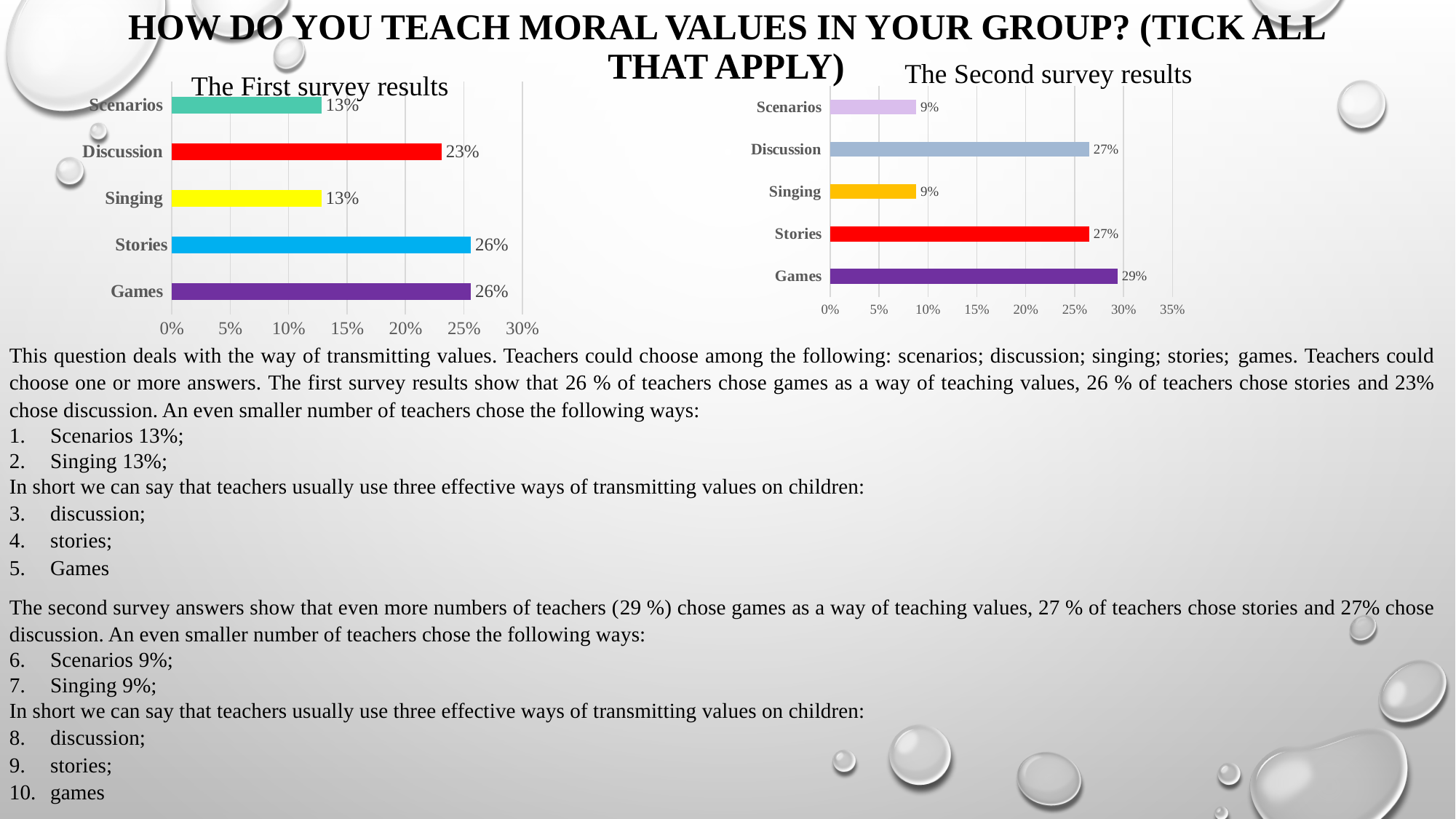
What kind of chart is "The Second survey results"? Bar chart In the chart titled "The Second survey results", which category has the highest value? Games In the chart titled "The Second survey results", what is the difference between the values for Discussion and Singing? 18% In the chart titled "The Second survey results", what is the value for Games? 29% In the chart titled "The First survey results", what is the difference between the values for Games and Scenarios? 13% In the chart titled "The First survey results", which category has the lowest value, Discussion or Singing? Singing How many categories are shown in the chart titled "The First survey results"? 5 In the chart titled "The Second survey results", what is the value for Scenarios? 9% In the chart titled "The First survey results", what is the value for Discussion? 23% In the chart titled "The First survey results", which is larger, the value for Stories or the value for Discussion? Stories In the chart titled "The Second survey results", is the value for Stories greater or less than 25%? greater What is the title of the chart on the left side of the slide? The First survey results